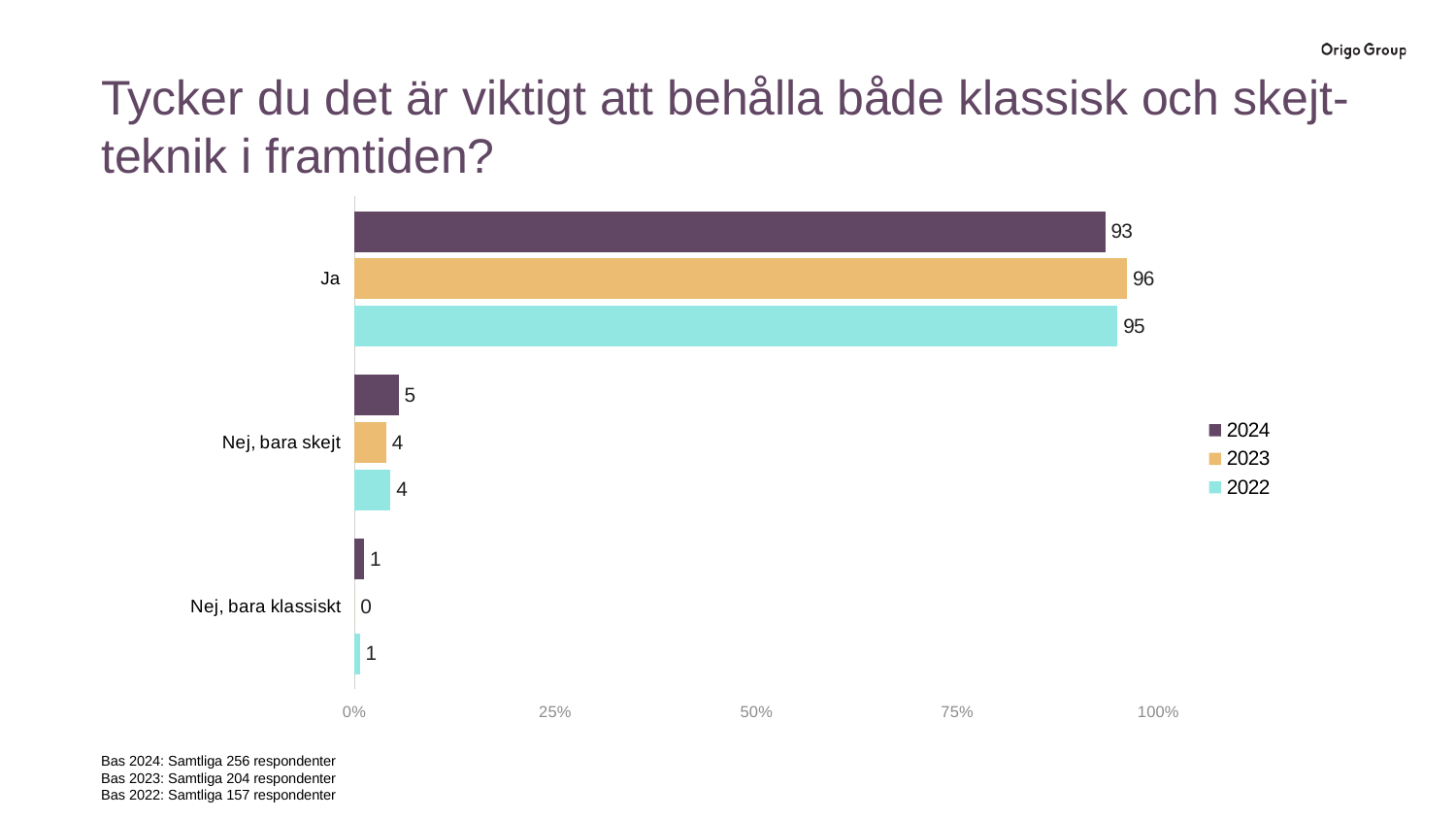
Is the 2022 value for "Ja" greater or less than 75%? greater Which year has the highest value for "Ja"? 2023 What is the value for "Nej, bara skejt" in the 2022 series? 4 What is the difference between the 2023 and 2024 values for "Ja"? 3 What is the value for "Ja" in the 2023 series? 96 What is the value for "Nej, bara klassiskt" in the 2023 series? 0 Which is larger: the 2022 value for "Ja" or the 2024 value for "Ja"? 2022 How many series does the legend list? 3 What is the value for "Ja" in the 2024 series? 93 Which category has the lowest value in the 2024 series? Nej, bara klassiskt What kind of chart is shown on the slide? Bar chart How many categories are shown on the chart? 3